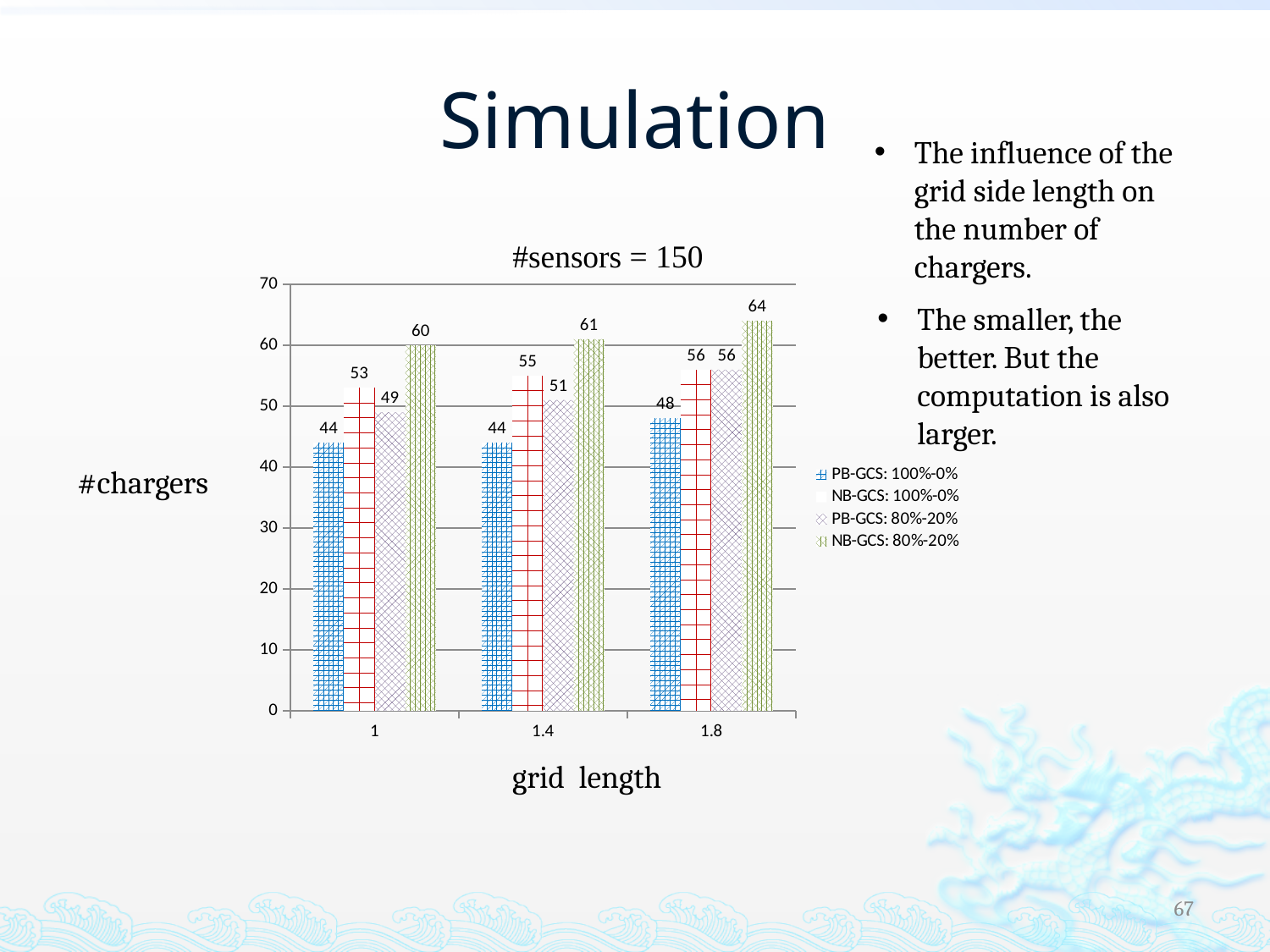
What is the difference between NB-GCS: 80%-20% and PB-GCS: 100%-0% at grid length 1? 16 What is the value of PB-GCS: 80%-20% at grid length 1? 49 What is the value of NB-GCS: 100%-0% at grid length 1.4? 55 How many grid length categories are shown on the x axis? 3 What is the value of PB-GCS: 100%-0% at grid length 1? 44 Which series has the lowest value at grid length 1.8? PB-GCS: 100%-0% What kind of chart is shown? Bar chart What is the title of the chart? #sensors = 150 What is the value of NB-GCS: 80%-20% at grid length 1.8? 64 Which series has the highest value at grid length 1.4? NB-GCS: 80%-20% Which is larger: NB-GCS: 100%-0% at grid length 1 or PB-GCS: 80%-20% at grid length 1.4? NB-GCS: 100%-0% at grid length 1 How many series does the legend list? 4